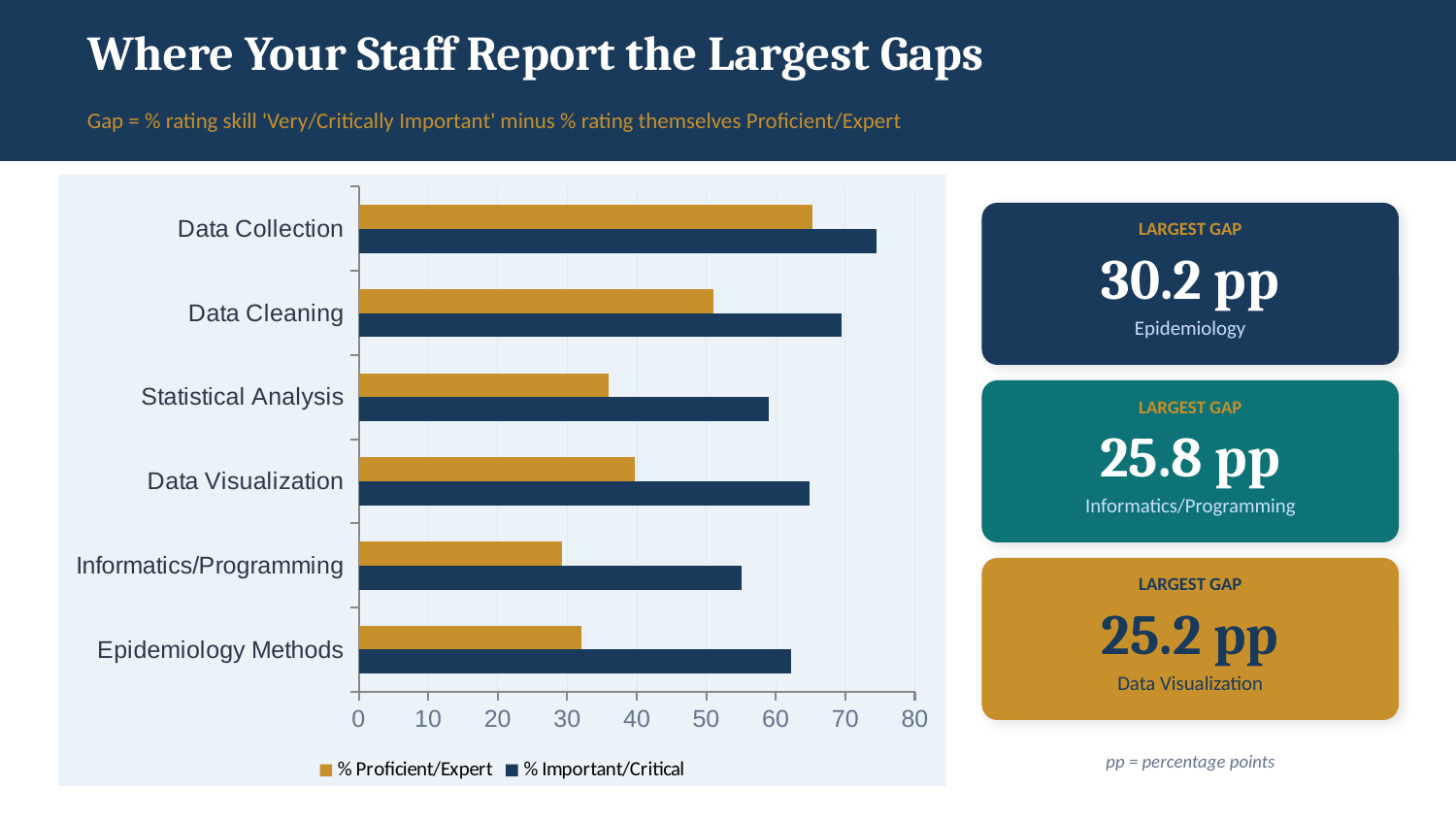
Which category has the highest value for % Proficient/Expert? Data Collection How many series does the chart legend list? 2 How many skill categories are plotted on the chart? 6 Is the % Important/Critical value for Data Visualization greater or less than 60? greater Which has the larger % Important/Critical value, Epidemiology Methods or Informatics/Programming? Epidemiology Methods What kind of chart is shown on the slide? Bar chart Which category has the highest value for % Important/Critical? Data Collection Is the % Important/Critical value for Data Collection greater or less than 70? greater Which series is shown in gold/orange bars according to the legend? % Proficient/Expert Which has the larger % Important/Critical value, Data Cleaning or Statistical Analysis? Data Cleaning Which category has the lowest value for % Proficient/Expert? Informatics/Programming